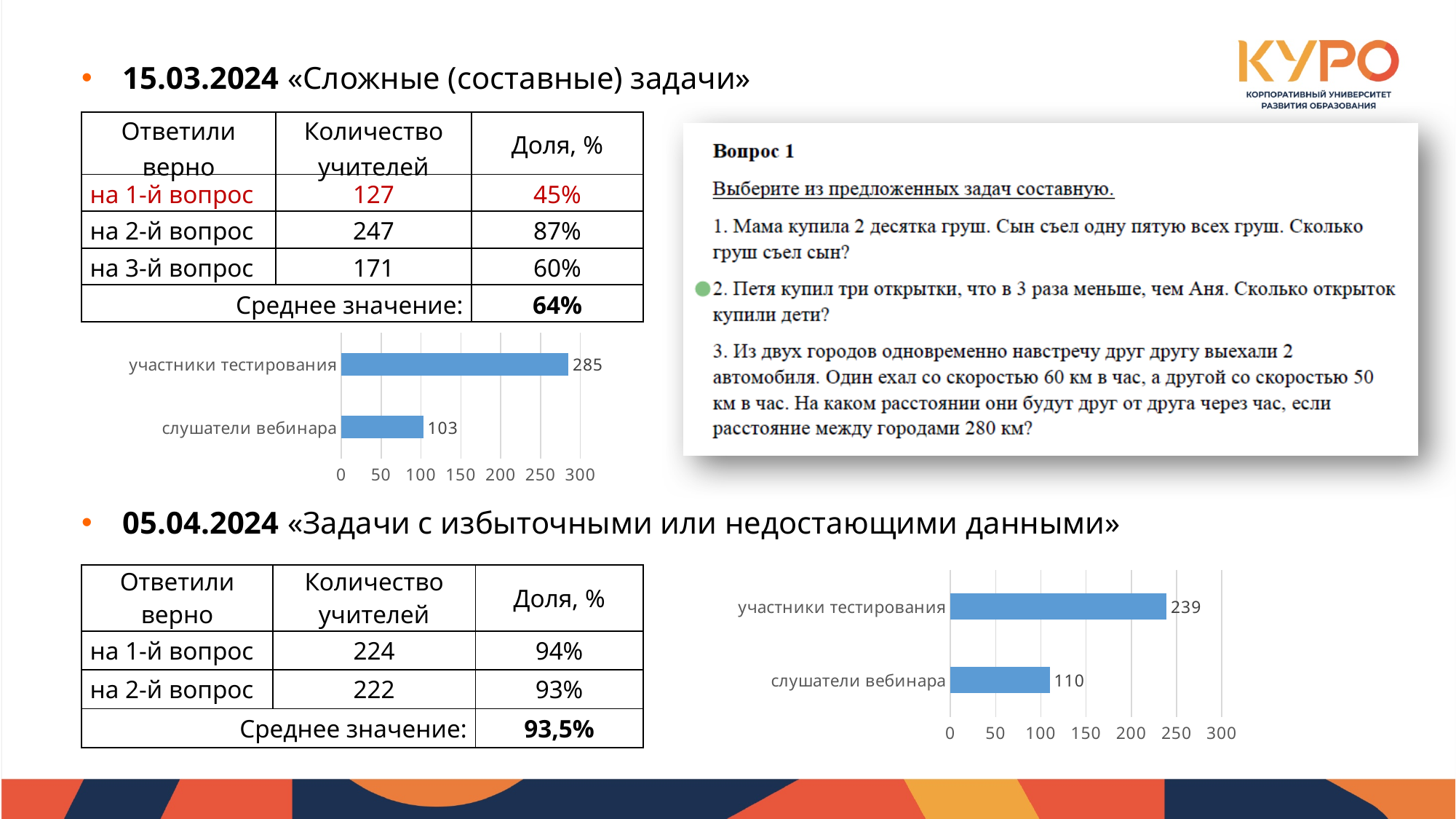
In the upper chart, is the value for слушатели вебинара greater or less than 150? less In the lower chart, what is the value for участники тестирования? 239 In the upper chart, what is the value for участники тестирования? 285 In the lower chart, what is the value for слушатели вебинара? 110 In the lower chart, which category has the lowest value? слушатели вебинара In the upper chart, which category has the highest value? участники тестирования What type of chart is the upper chart? bar chart How many categories does the lower chart show? 2 In the lower chart, what is the difference between участники тестирования and слушатели вебинара? 129 In the upper chart, what is the difference between участники тестирования and слушатели вебинара? 182 In the lower chart, which is larger: участники тестирования or слушатели вебинара? участники тестирования In the upper chart, what is the value for слушатели вебинара? 103